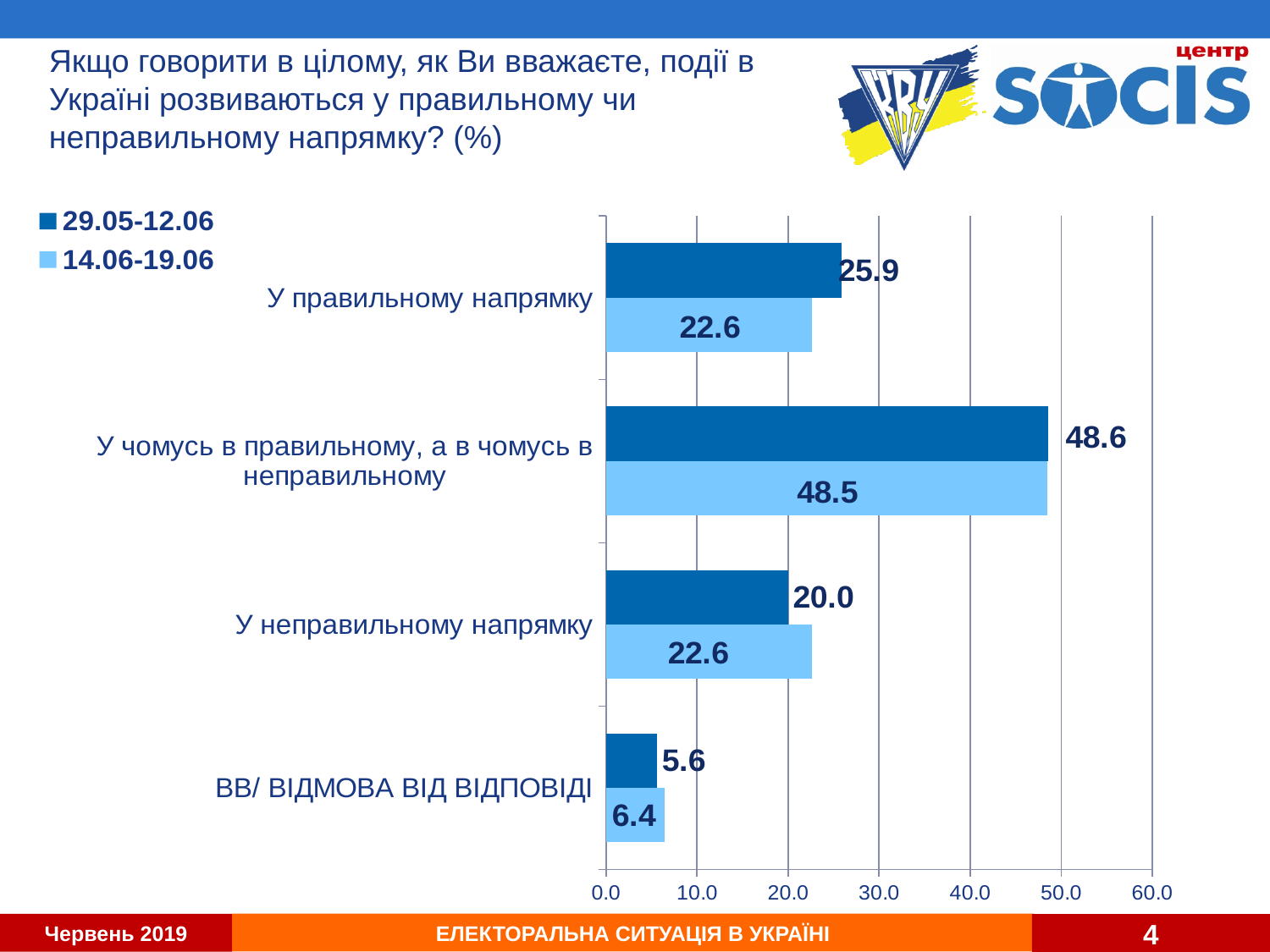
Which series is shown in light blue according to the legend? 14.06-19.06 How many categories are shown on the chart? 4 What is the value for "У чомусь в правильному, а в чомусь в неправильному" in the 14.06-19.06 series? 48.5 For "У неправильному напрямку", which series has the larger value: 29.05-12.06 or 14.06-19.06? 14.06-19.06 What kind of chart is shown on the slide? Bar chart What is the value for "У неправильному напрямку" in the 14.06-19.06 series? 22.6 Which category has the highest value in the 29.05-12.06 series? У чомусь в правильному, а в чомусь в неправильному Which category has the lowest value in the 14.06-19.06 series? ВВ/ ВІДМОВА ВІД ВІДПОВІДІ What is the value for "ВВ/ ВІДМОВА ВІД ВІДПОВІДІ" in the 29.05-12.06 series? 5.6 What is the difference between the 29.05-12.06 and 14.06-19.06 values for "У правильному напрямку"? 3.3 How many series does the legend list? 2 What is the value for "У правильному напрямку" in the 29.05-12.06 series? 25.9